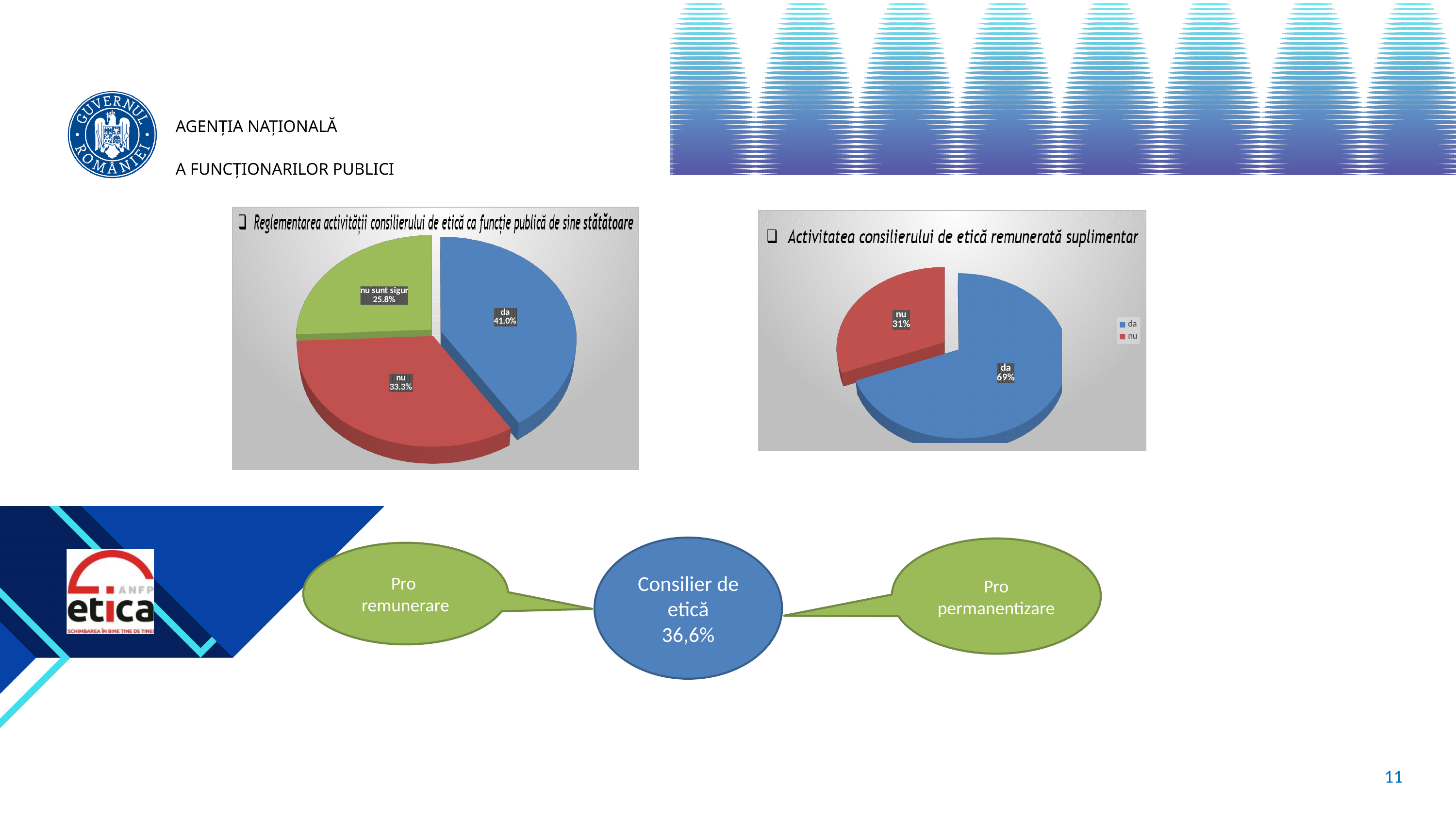
In the left pie chart (Reglementarea activității consilierului de etică ca funcție publică de sine stătătoare), what is the share for "nu"? 33.3% In the right pie chart (Activitatea consilierului de etică remunerată suplimentar), how many entries does the legend list? 2 In the left pie chart (Reglementarea activității consilierului de etică ca funcție publică de sine stătătoare), what is the share for "da"? 41.0% In the left pie chart (Reglementarea activității consilierului de etică ca funcție publică de sine stătătoare), which category has the smallest share? nu sunt sigur In the right pie chart (Activitatea consilierului de etică remunerată suplimentar), what is the share for "da"? 69% In the right pie chart (Activitatea consilierului de etică remunerată suplimentar), which is larger, "da" or "nu"? da In the right pie chart (Activitatea consilierului de etică remunerată suplimentar), what is the share for "nu"? 31% In the left pie chart (Reglementarea activității consilierului de etică ca funcție publică de sine stătătoare), what is the share for "nu sunt sigur"? 25.8% In the left pie chart (Reglementarea activității consilierului de etică ca funcție publică de sine stătătoare), which category has the largest share? da In the left pie chart (Reglementarea activității consilierului de etică ca funcție publică de sine stătătoare), how many slices are there? 3 What type of chart is the right chart (Activitatea consilierului de etică remunerată suplimentar)? Pie chart In the left pie chart (Reglementarea activității consilierului de etică ca funcție publică de sine stătătoare), what is the difference in percentage points between "da" and "nu"? 7.7